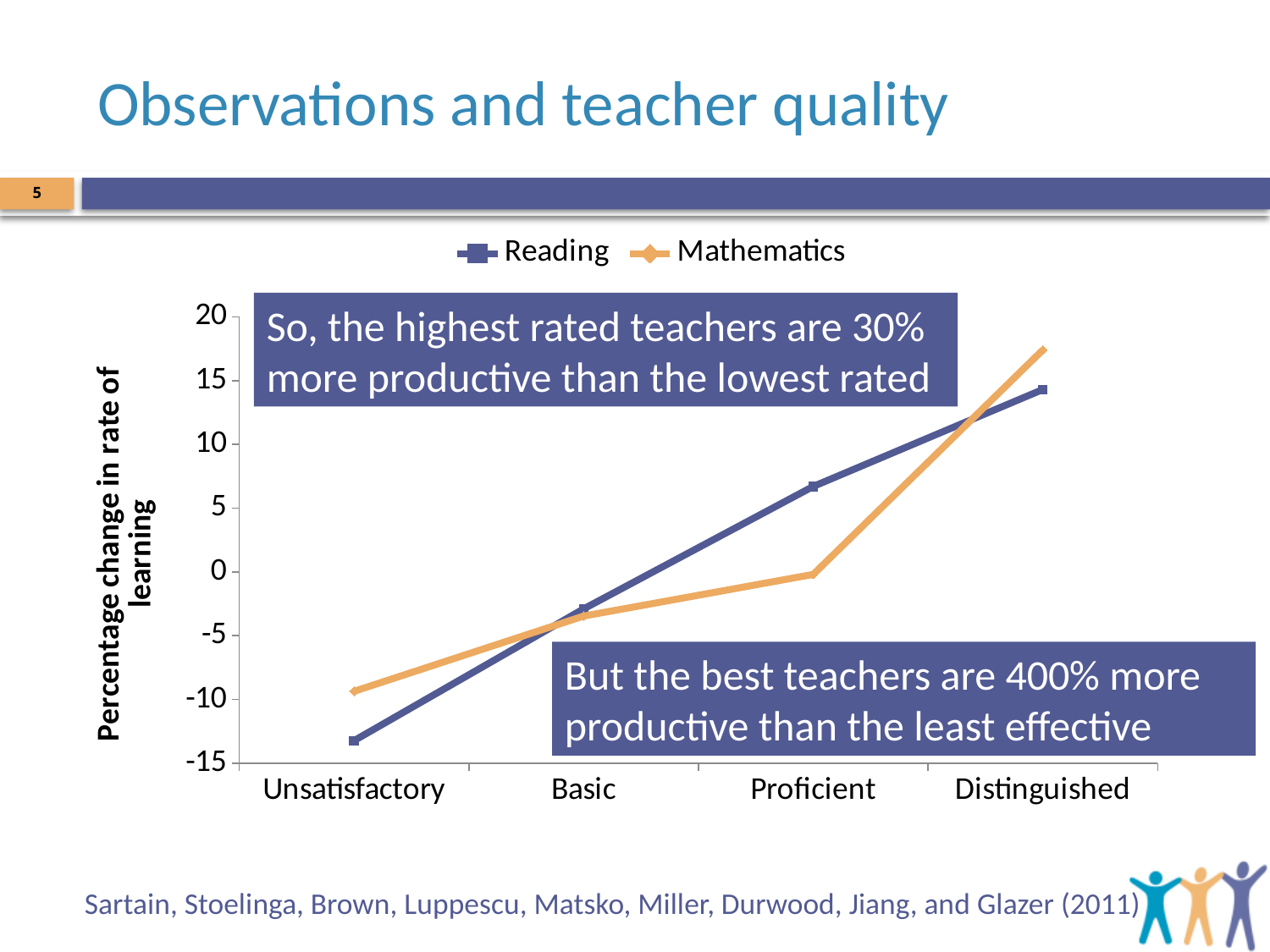
What kind of chart is shown on the slide? line chart What is the title of the vertical axis? Percentage change in rate of learning Do the Reading values rise or fall from Unsatisfactory to Distinguished? rise How many categories are shown on the x axis? 4 Which series are listed in the legend? Reading and Mathematics Is the Mathematics value for Distinguished greater or less than 15? greater Is the Reading value for Proficient greater or less than 5? greater At Proficient, which series has the higher value, Reading or Mathematics? Reading How many series does the legend list? 2 Is the Mathematics value for Proficient greater or less than 5? less At Distinguished, which series has the higher value, Reading or Mathematics? Mathematics